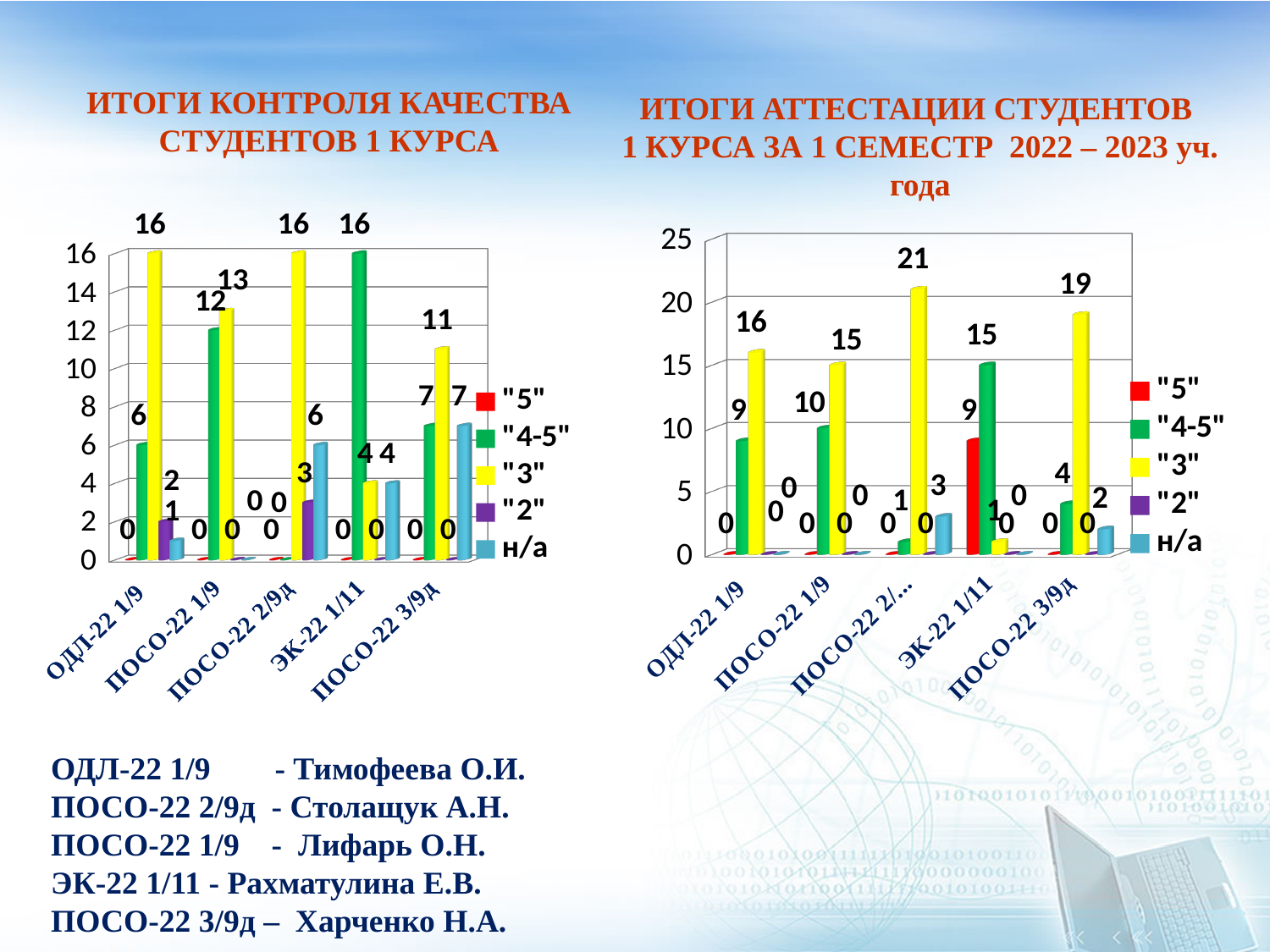
In the left chart (ИТОГИ КОНТРОЛЯ КАЧЕСТВА СТУДЕНТОВ 1 КУРСА), which category has the highest "4-5" value? ЭК-22 1/11 In the left chart (ИТОГИ КОНТРОЛЯ КАЧЕСТВА СТУДЕНТОВ 1 КУРСА), how many series does the legend list? 5 In the right chart (ИТОГИ АТТЕСТАЦИИ СТУДЕНТОВ 1 КУРСА ЗА 1 СЕМЕСТР), what is the value of the "3" series for ПОСО-22 3/9д? 19 In the left chart (ИТОГИ КОНТРОЛЯ КАЧЕСТВА СТУДЕНТОВ 1 КУРСА), what is the value of the "4-5" series for ПОСО-22 1/9? 12 In the right chart (ИТОГИ АТТЕСТАЦИИ СТУДЕНТОВ 1 КУРСА ЗА 1 СЕМЕСТР), which is larger: the "4-5" value for ОДЛ-22 1/9 or for ПОСО-22 1/9? ПОСО-22 1/9 What type of chart is the left chart (ИТОГИ КОНТРОЛЯ КАЧЕСТВА СТУДЕНТОВ 1 КУРСА)? Bar chart In the right chart (ИТОГИ АТТЕСТАЦИИ СТУДЕНТОВ 1 КУРСА ЗА 1 СЕМЕСТР), which category has the highest "3" value? ПОСО-22 2/... In the right chart (ИТОГИ АТТЕСТАЦИИ СТУДЕНТОВ 1 КУРСА ЗА 1 СЕМЕСТР), what is the value of the "5" series for ЭК-22 1/11? 9 In the left chart (ИТОГИ КОНТРОЛЯ КАЧЕСТВА СТУДЕНТОВ 1 КУРСА), what is the value of the "3" series for ОДЛ-22 1/9? 16 In the left chart (ИТОГИ КОНТРОЛЯ КАЧЕСТВА СТУДЕНТОВ 1 КУРСА), what is the difference between the "3" and "4-5" values for ПОСО-22 3/9д? 4 In the right chart (ИТОГИ АТТЕСТАЦИИ СТУДЕНТОВ 1 КУРСА ЗА 1 СЕМЕСТР), what is the difference between the "3" and "4-5" values for ОДЛ-22 1/9? 7 How many categories are shown on the x axis of the right chart (ИТОГИ АТТЕСТАЦИИ СТУДЕНТОВ 1 КУРСА ЗА 1 СЕМЕСТР)? 5